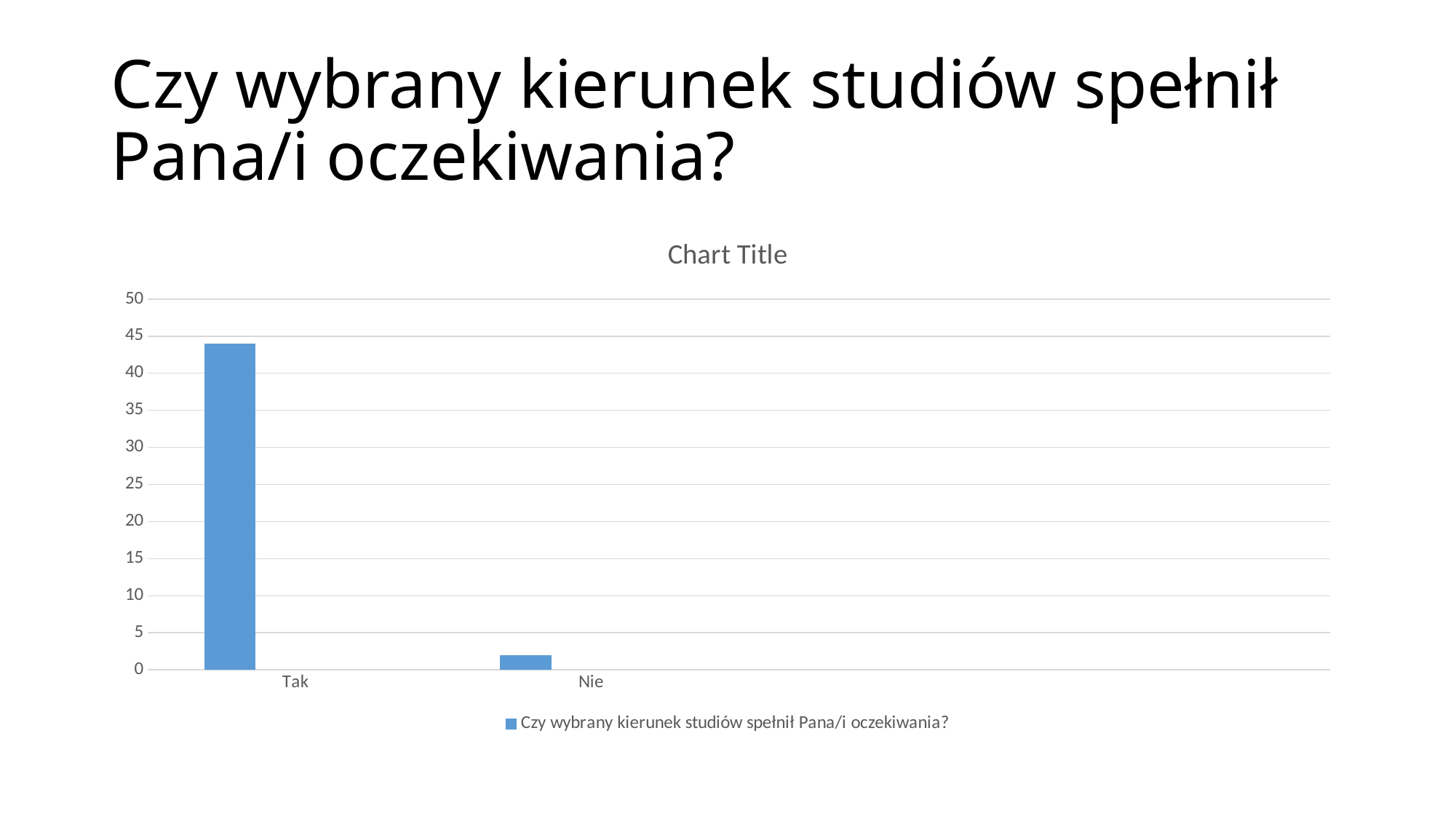
Is the value for Nie greater or less than 5? less What is the name of the series listed in the chart legend? Czy wybrany kierunek studiów spełnił Pana/i oczekiwania? How many categories are shown on the x axis of the chart? 2 How many series does the chart legend list? 1 What kind of chart is shown on the slide? bar chart Which category has the lowest bar in the chart? Nie Is the value for Nie greater or less than 10? less Is the value for Tak greater or less than 40? greater What is the title shown above the chart? Chart Title Which category has the highest bar in the chart? Tak Which is larger, the value for Tak or the value for Nie? Tak